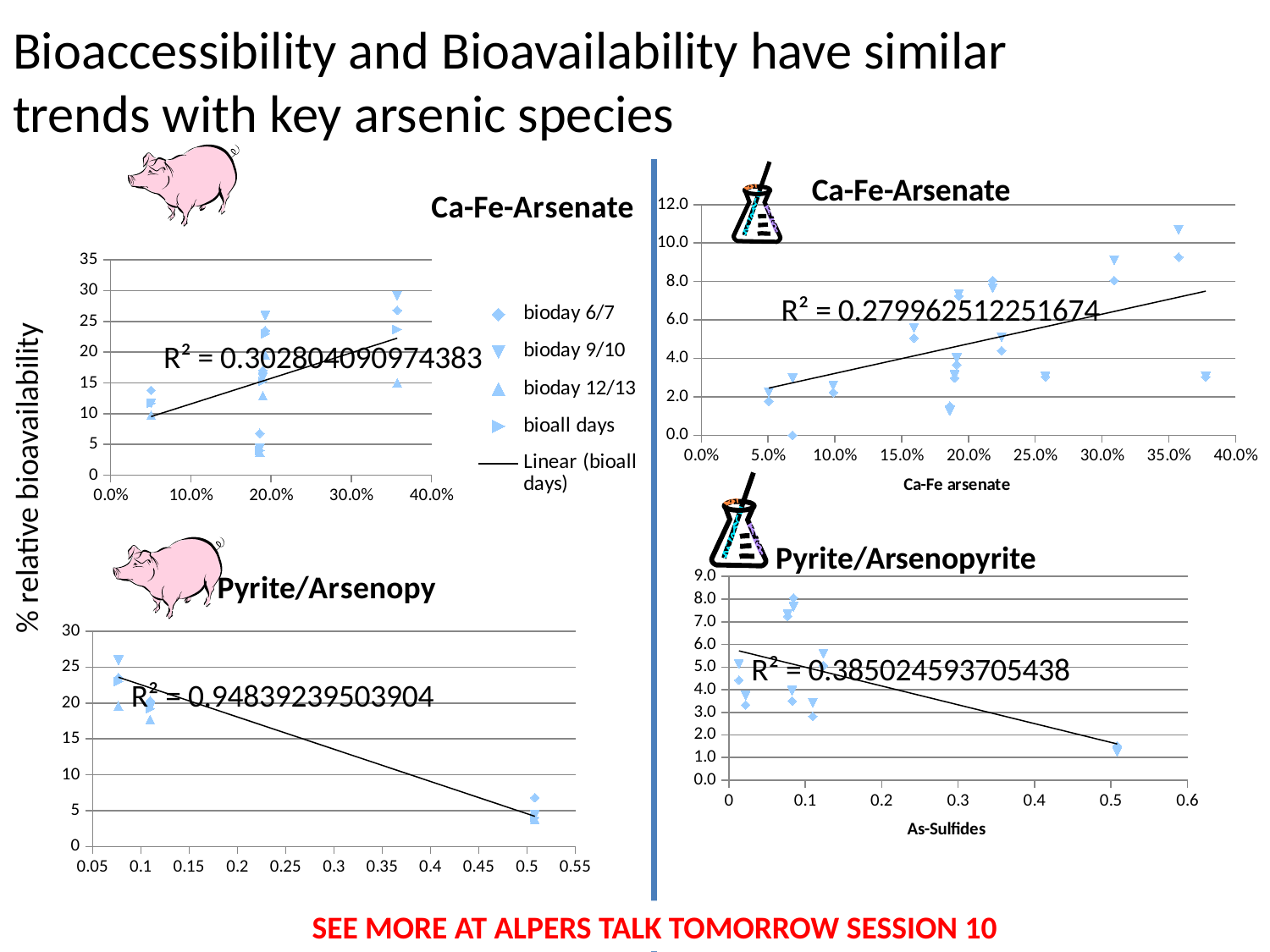
What is the x-axis title of the top-right Ca-Fe-Arsenate chart? Ca-Fe arsenate In the top-right Ca-Fe-Arsenate chart, does the trend line rise or fall as the x value increases? rise In the bottom-left Pyrite/Arsenopy chart, does the trend line rise or fall as the x value increases? fall What R² value is printed on the bottom-right Pyrite/Arsenopyrite chart? R² = 0.385024593705438 What R² value is printed on the top-left Ca-Fe-Arsenate chart? R² = 0.302804090974383 What R² value is printed on the top-right Ca-Fe-Arsenate chart? R² = 0.279962512251674 Which chart has the highest R² value printed on it? Pyrite/Arsenopy (bottom-left) Which chart has the lowest R² value printed on it? Ca-Fe-Arsenate (top-right) What R² value is printed on the bottom-left Pyrite/Arsenopy chart? R² = 0.94839239503904 What kind of chart is the top-left chart titled Ca-Fe-Arsenate? scatter chart How many entries does the legend of the top-left Ca-Fe-Arsenate chart list? 5 What is the x-axis title of the bottom-right Pyrite/Arsenopyrite chart? As-Sulfides